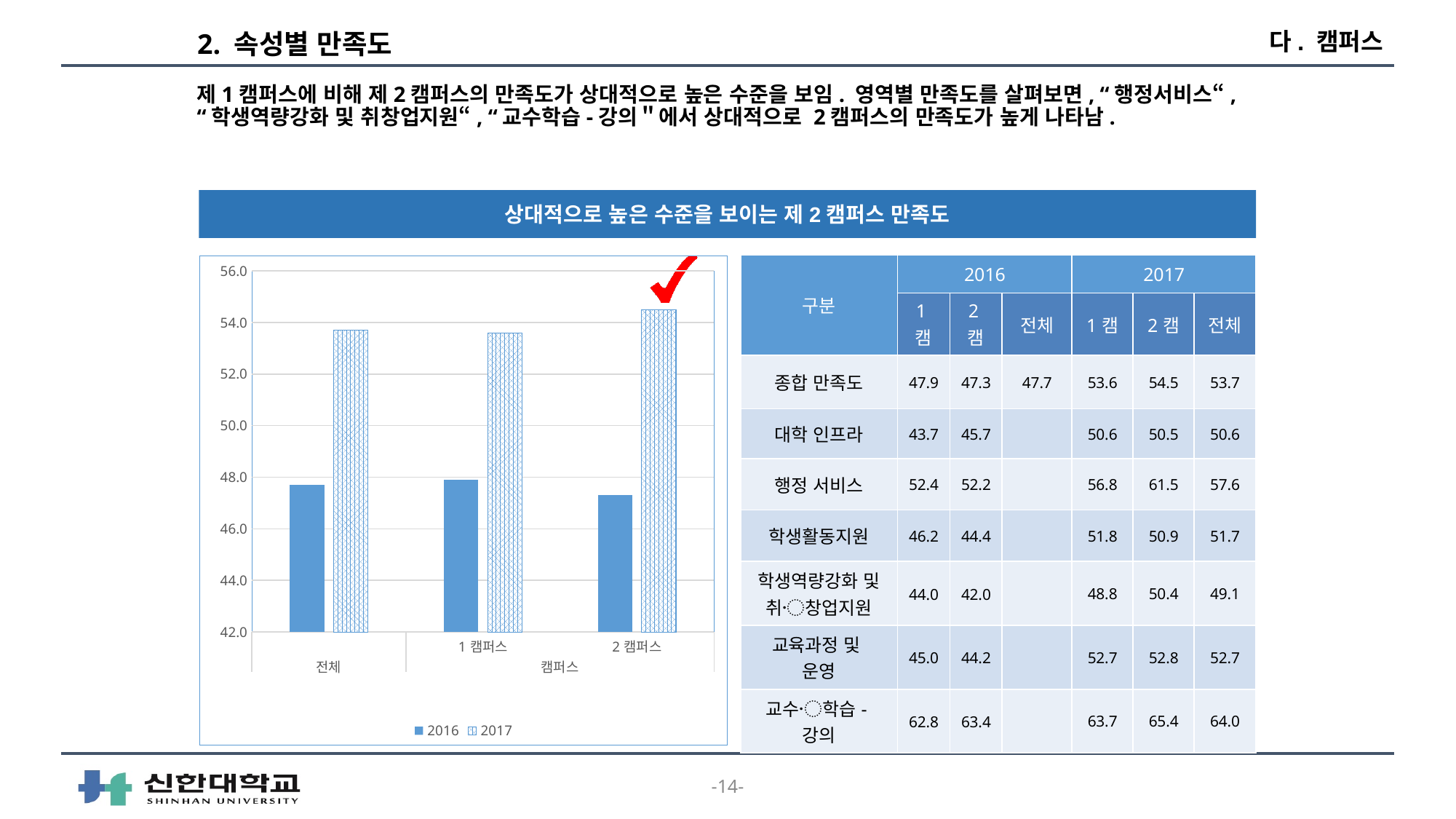
Is the 2016 value for 2 캠퍼스 greater or less than 48.0? less In every category, which series has the taller bar, 2016 or 2017? 2017 Which category has the highest 2017 value in the chart? 2 캠퍼스 Which years are listed in the chart legend? 2016 and 2017 How many categories are shown on the x axis of the chart? 3 What kind of chart is shown on the slide? bar chart For 2017, which is larger: the value for 1 캠퍼스 or the value for 2 캠퍼스? 2 캠퍼스 Is the 2016 value for 전체 greater or less than 46.0? greater Is the 2017 value for 전체 greater or less than 52.0? greater How many series does the chart legend list? 2